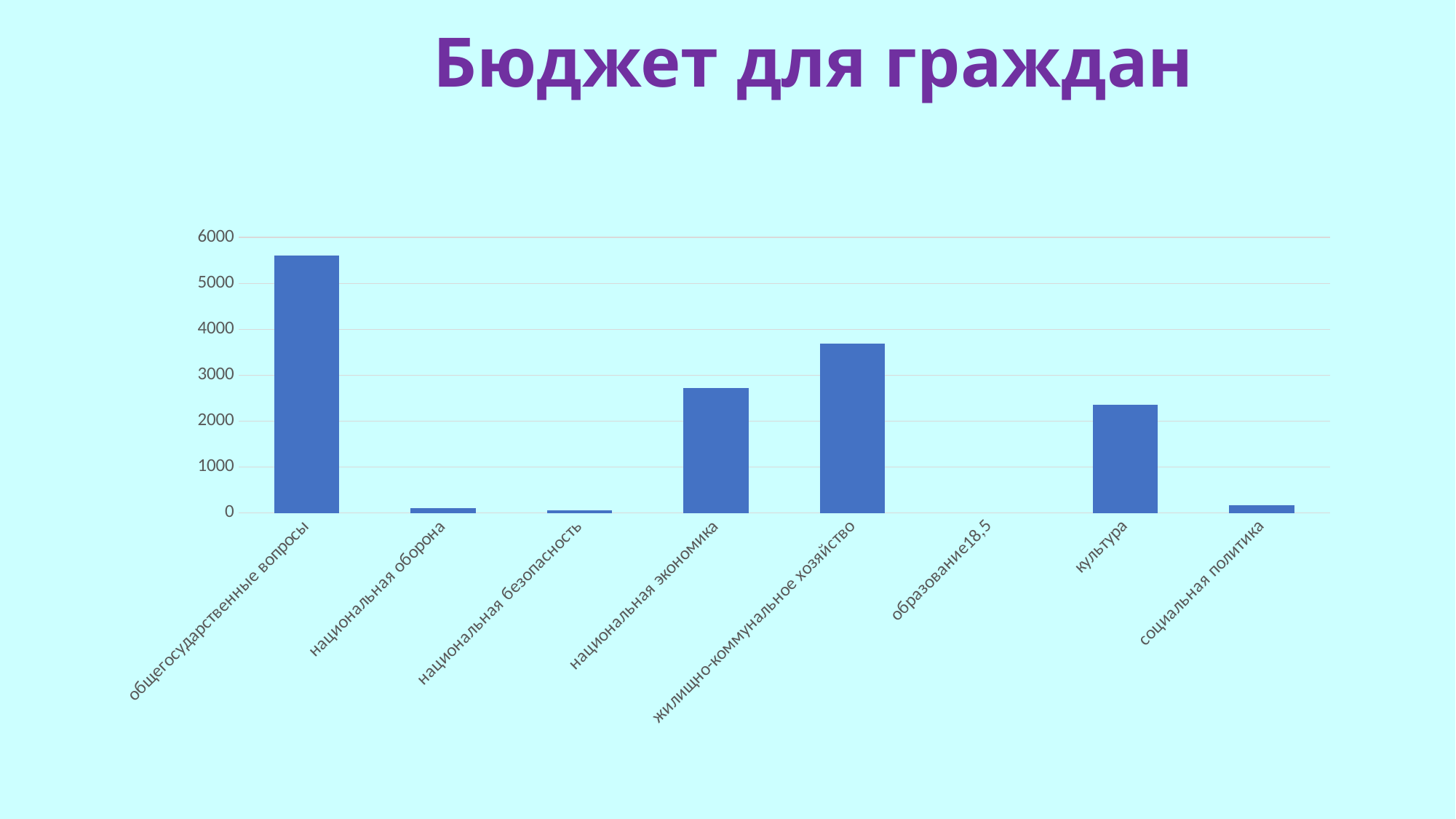
How many categories are shown on the x axis of the chart? 8 What kind of chart is shown on the slide? bar chart Which category has the highest value in the chart? общегосударственные вопросы Is the value for национальная экономика greater or less than 3000? less Is the value for жилищно-коммунальное хозяйство greater or less than 3000? greater Is the value for жилищно-коммунальное хозяйство greater or less than 4000? less What is the title of the slide? Бюджет для граждан Which is larger, the value for жилищно-коммунальное хозяйство or the value for национальная экономика? жилищно-коммунальное хозяйство Which is larger, the value for общегосударственные вопросы or the value for жилищно-коммунальное хозяйство? общегосударственные вопросы